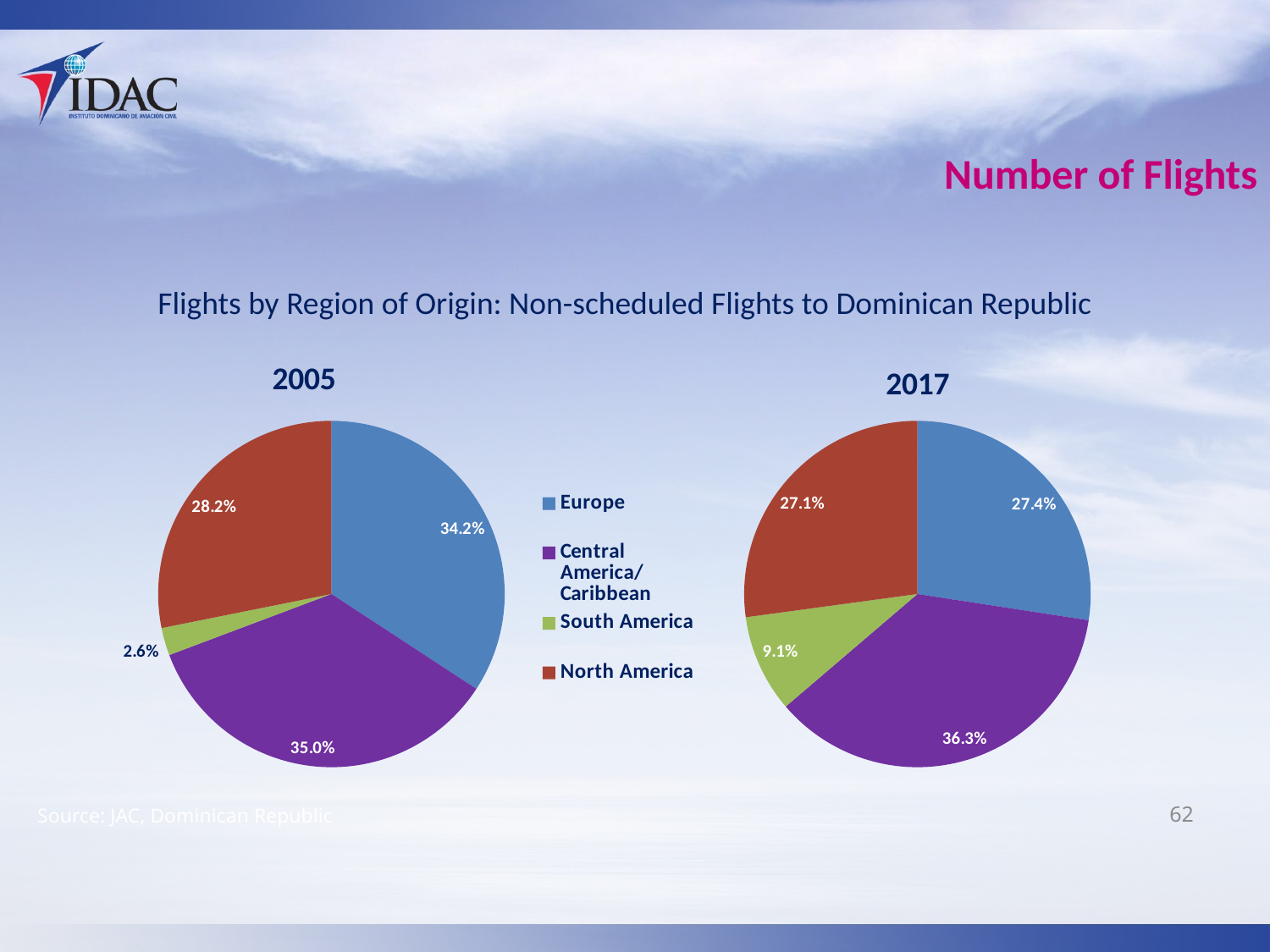
What type of chart is used to show flights by region of origin? Pie chart In the 2017 pie chart, which region has the smallest share? South America How many regions are shown in each pie chart? 4 In the 2005 pie chart, what share of flights came from North America? 28.2% Is the Europe share larger in the 2005 chart or the 2017 chart? 2005 In the 2017 pie chart, which region has the largest share? Central America/Caribbean Which colour represents North America in the pie charts? Red In the 2005 pie chart, what share of non-scheduled flights came from Europe? 34.2% In the 2017 pie chart, what share of non-scheduled flights came from South America? 9.1% In the 2005 pie chart, which region has the smallest share? South America In the 2005 pie chart, what is the difference between the Central America/Caribbean share and the North America share? 6.8% What is the difference between the South America share in 2017 and in 2005? 6.5%